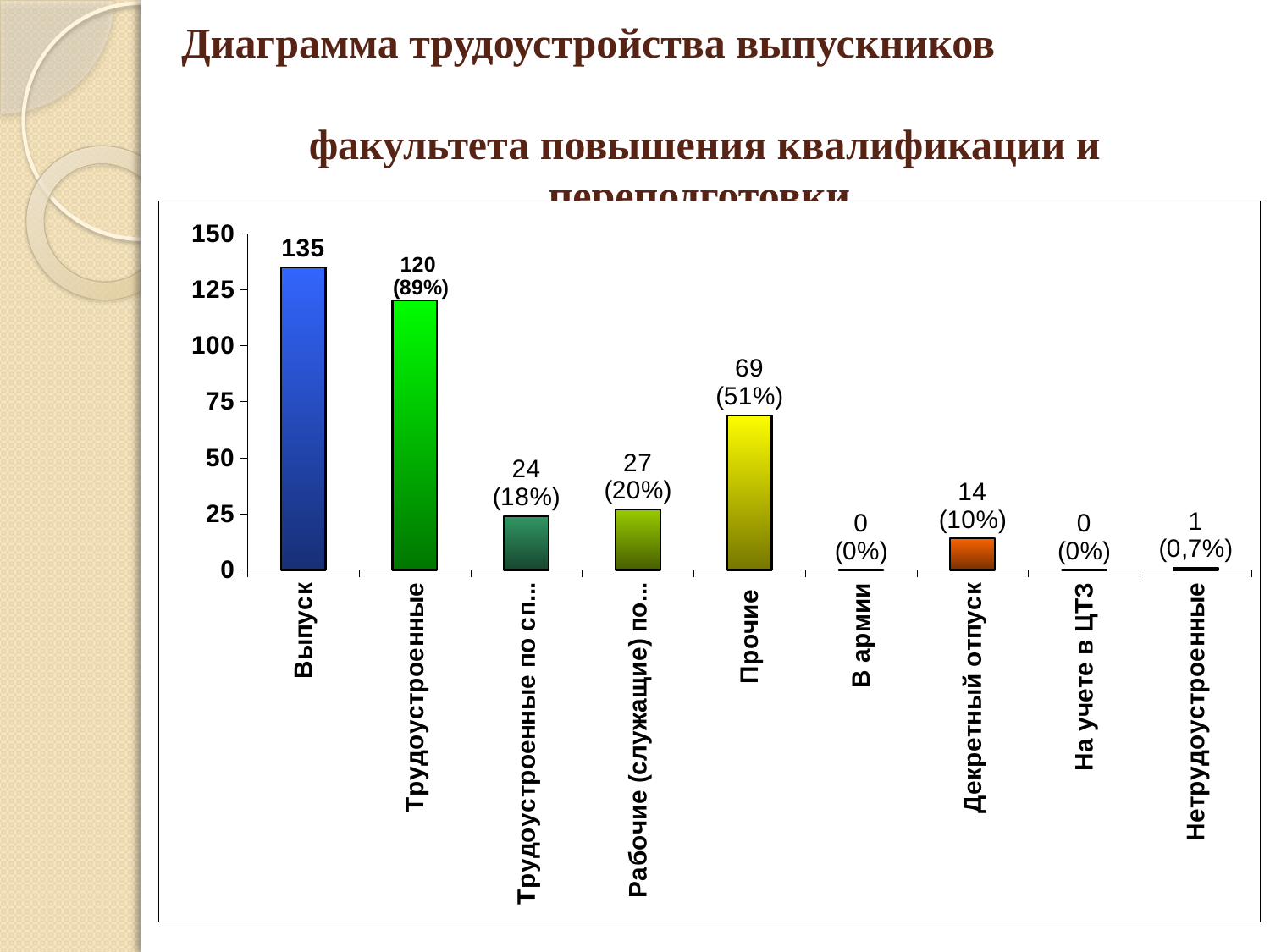
What kind of chart is shown on the slide? bar chart What is the value for Декретный отпуск? 14 What is the difference between the values for Прочие and Декретный отпуск? 55 How many categories are shown on the x axis of the chart? 9 Which category has the highest value? Выпуск What is the difference between the values for Выпуск and Трудоустроенные? 15 What is the value for Трудоустроенные? 120 How many categories have a value of 0? 2 What percentage is shown for Нетрудоустроенные? 0,7% Which is larger, the value for Прочие or the value for Декретный отпуск? Прочие What percentage is shown for Прочие? 51% What is the value for Выпуск? 135